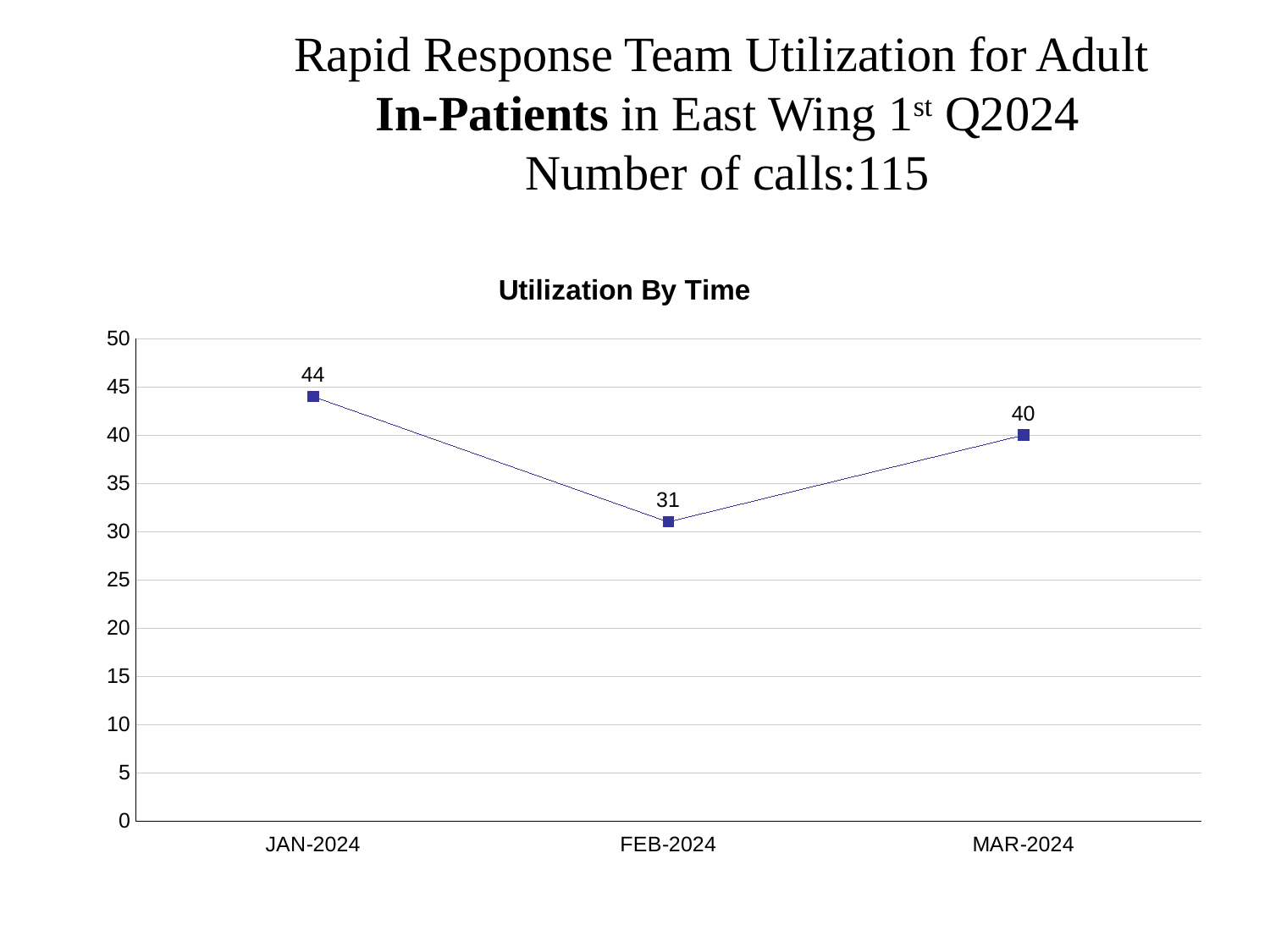
How many data points are plotted on the chart? 3 What is the difference between the values for MAR-2024 and FEB-2024? 9 Which month has the lowest value? FEB-2024 What is the title of the chart? Utilization By Time What is the value for FEB-2024? 31 What is the difference between the values for JAN-2024 and FEB-2024? 13 What kind of chart is shown on the slide? line chart What is the value for JAN-2024? 44 Is the value for FEB-2024 greater or less than 35? less What is the value for MAR-2024? 40 Which is larger, the value for JAN-2024 or the value for MAR-2024? JAN-2024 Which month has the highest value? JAN-2024